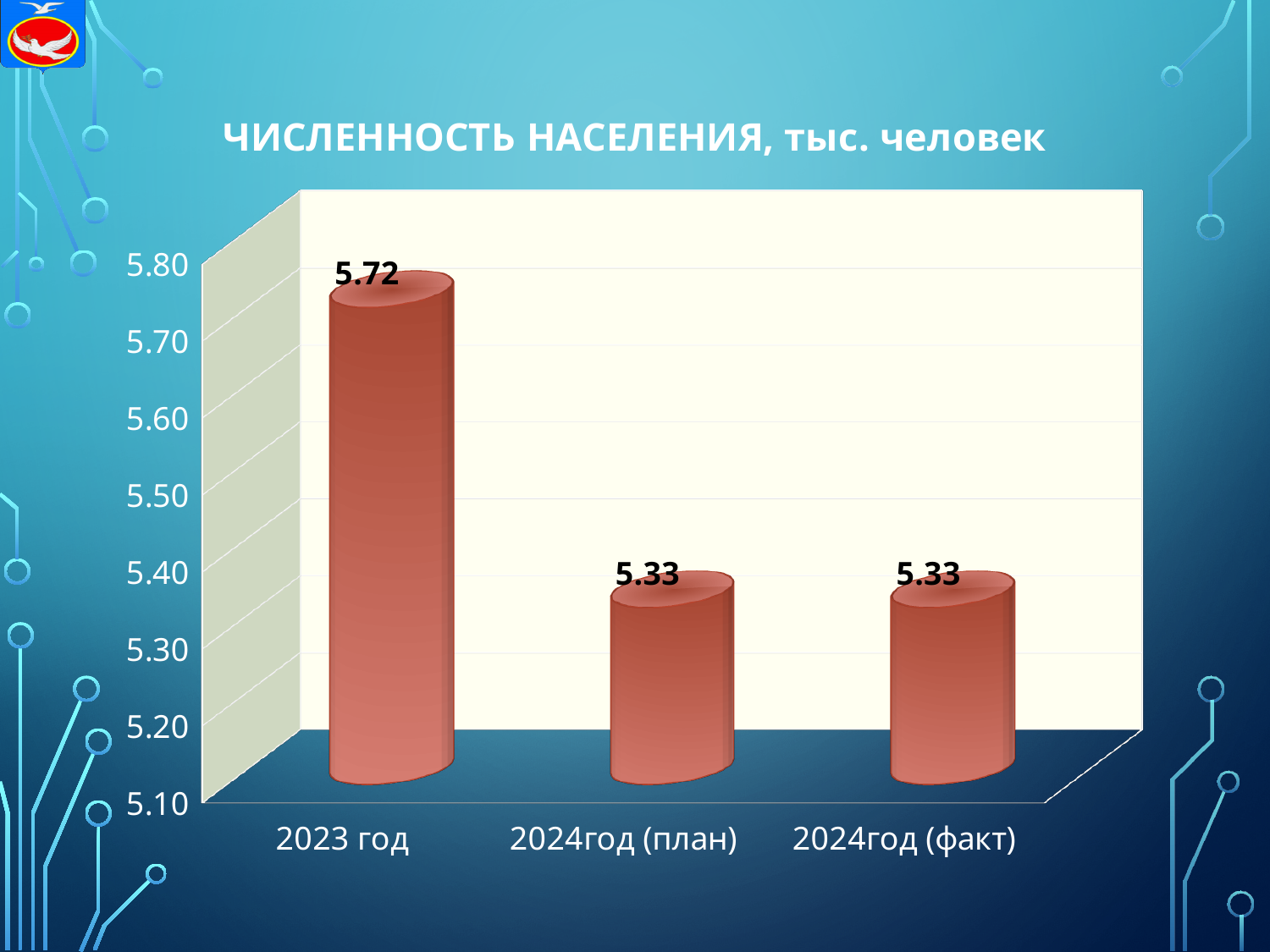
What is the value for 2023 год? 5.72 Is the value for 2023 год greater or less than 5.60? greater What is the value for 2024год (план)? 5.33 Do the values rise or fall from 2023 год to 2024год (план)? fall Which is larger, the value for 2023 год or the value for 2024год (факт)? 2023 год What is the value for 2024год (факт)? 5.33 Is the value for 2024год (план) greater or less than 5.50? less What is the difference between the values for 2023 год and 2024год (план)? 0.39 How many categories are shown on the x axis? 3 What kind of chart is shown on the slide? bar chart Which category has the highest value? 2023 год What is the title of the chart? ЧИСЛЕННОСТЬ НАСЕЛЕНИЯ, тыс. человек